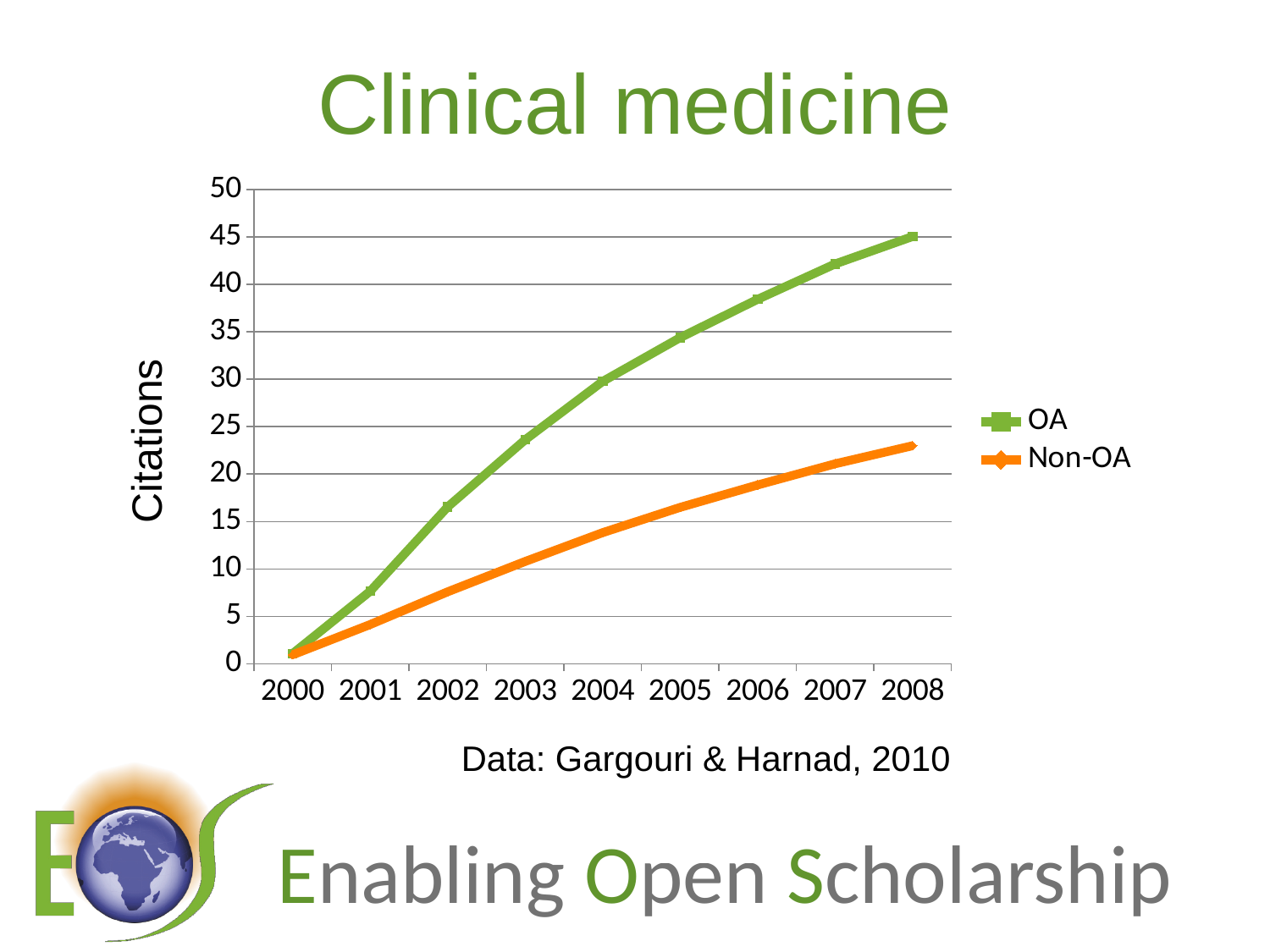
Do the OA citations rise or fall from 2000 to 2008? rise What is the label on the y axis? Citations Is the Non-OA value for 2004 greater or less than 20? less In which year does the OA series reach its highest value? 2008 In 2008, which series has more citations, OA or Non-OA? OA What kind of chart is shown on the slide? line chart Is the OA value for 2008 greater or less than 40? greater Is the OA value for 2003 greater or less than 20? greater How many series does the legend list? 2 How many years are shown along the x axis? 9 Do the Non-OA citations rise or fall from 2000 to 2008? rise